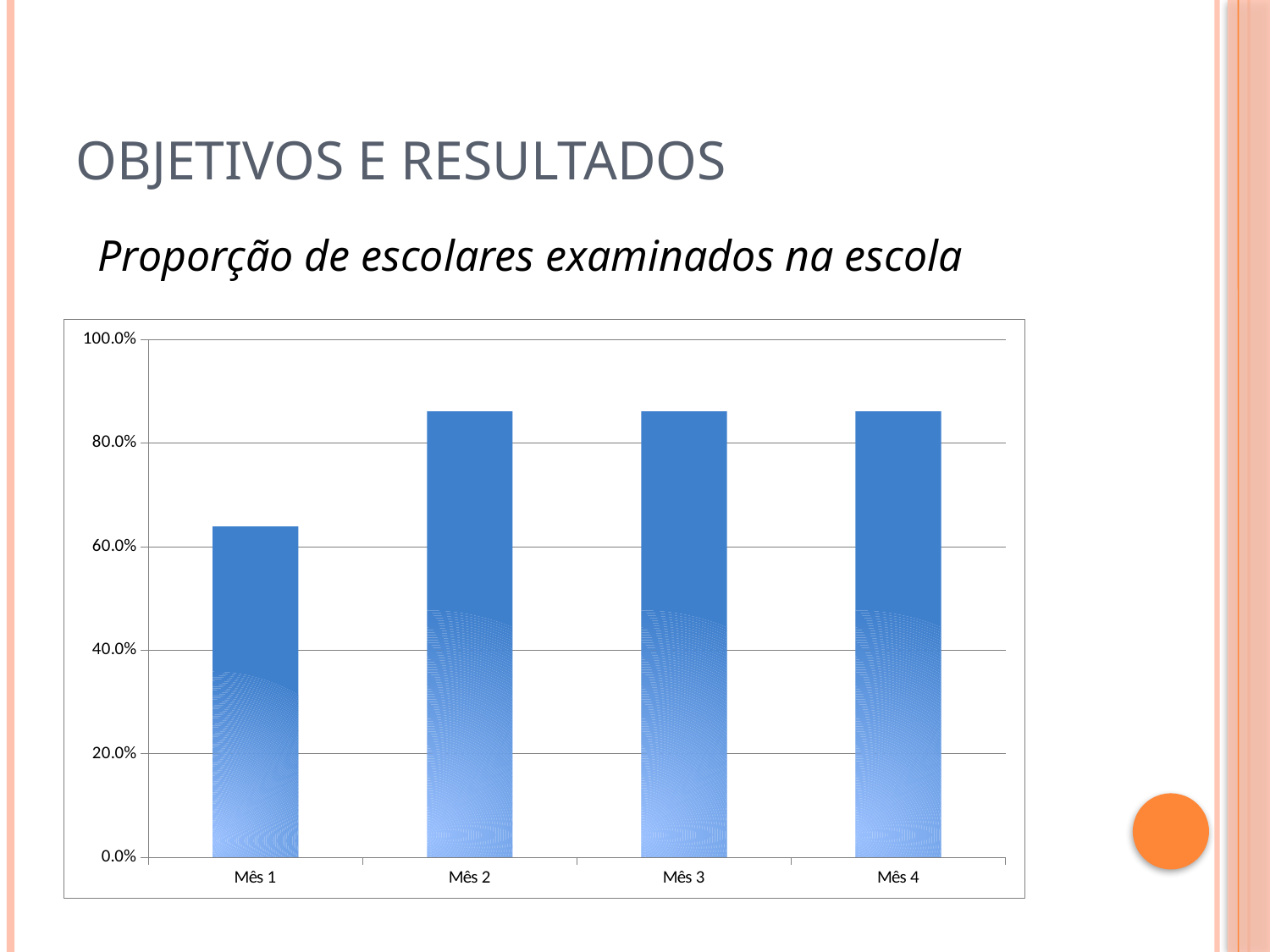
Is the value for Mês 2 greater or less than 80.0%? greater What is the highest tick value shown on the y axis of the chart? 100.0% Which is larger, the value for Mês 1 or the value for Mês 3? Mês 3 What is the title given above the chart on the slide? Proporção de escolares examinados na escola What kind of chart is shown on the slide? bar chart Is the value for Mês 1 greater or less than 80.0%? less Does the value rise or fall from Mês 1 to Mês 2? rise Which month has the lowest value in the chart? Mês 1 How many categories (months) are shown on the x axis of the chart? 4 Is the value for Mês 1 greater or less than 60.0%? greater